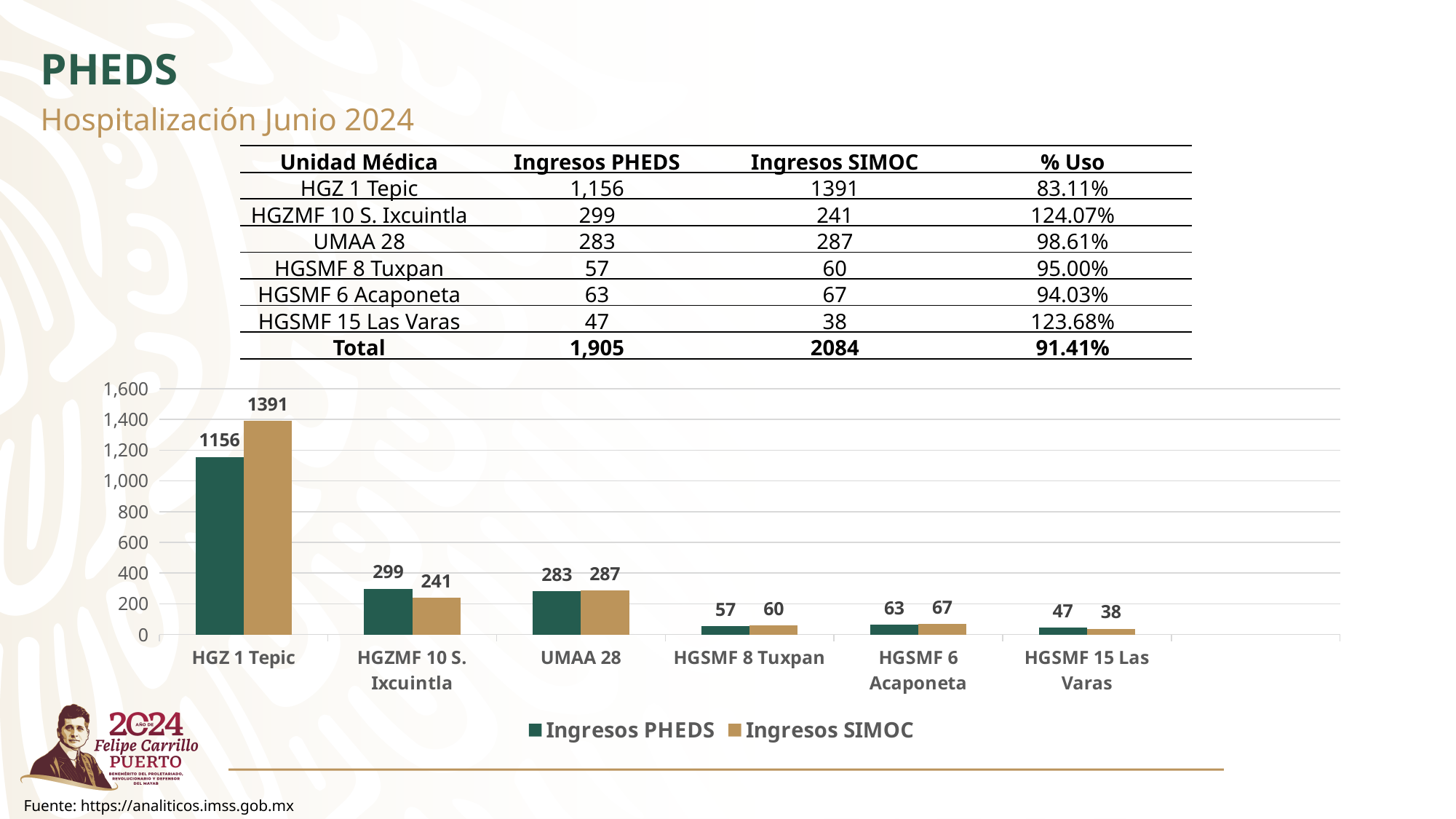
For HGZMF 10 S. Ixcuintla, which is larger: Ingresos PHEDS or Ingresos SIMOC? Ingresos PHEDS Which unit has the lowest Ingresos PHEDS value in the chart? HGSMF 15 Las Varas What is the Ingresos PHEDS value for HGZ 1 Tepic in the chart? 1156 Which unit has the highest Ingresos SIMOC value in the chart? HGZ 1 Tepic Which series is shown in green in the chart? Ingresos PHEDS What is the Ingresos SIMOC value for HGSMF 15 Las Varas in the chart? 38 Is the Ingresos PHEDS value for UMAA 28 greater or less than 400? less What type of chart is shown on the slide? bar chart What is the Ingresos SIMOC value for HGZMF 10 S. Ixcuintla in the chart? 241 How many medical units are shown on the x axis of the chart? 6 How many series does the chart legend list? 2 What is the difference between Ingresos SIMOC and Ingresos PHEDS for HGZ 1 Tepic? 235